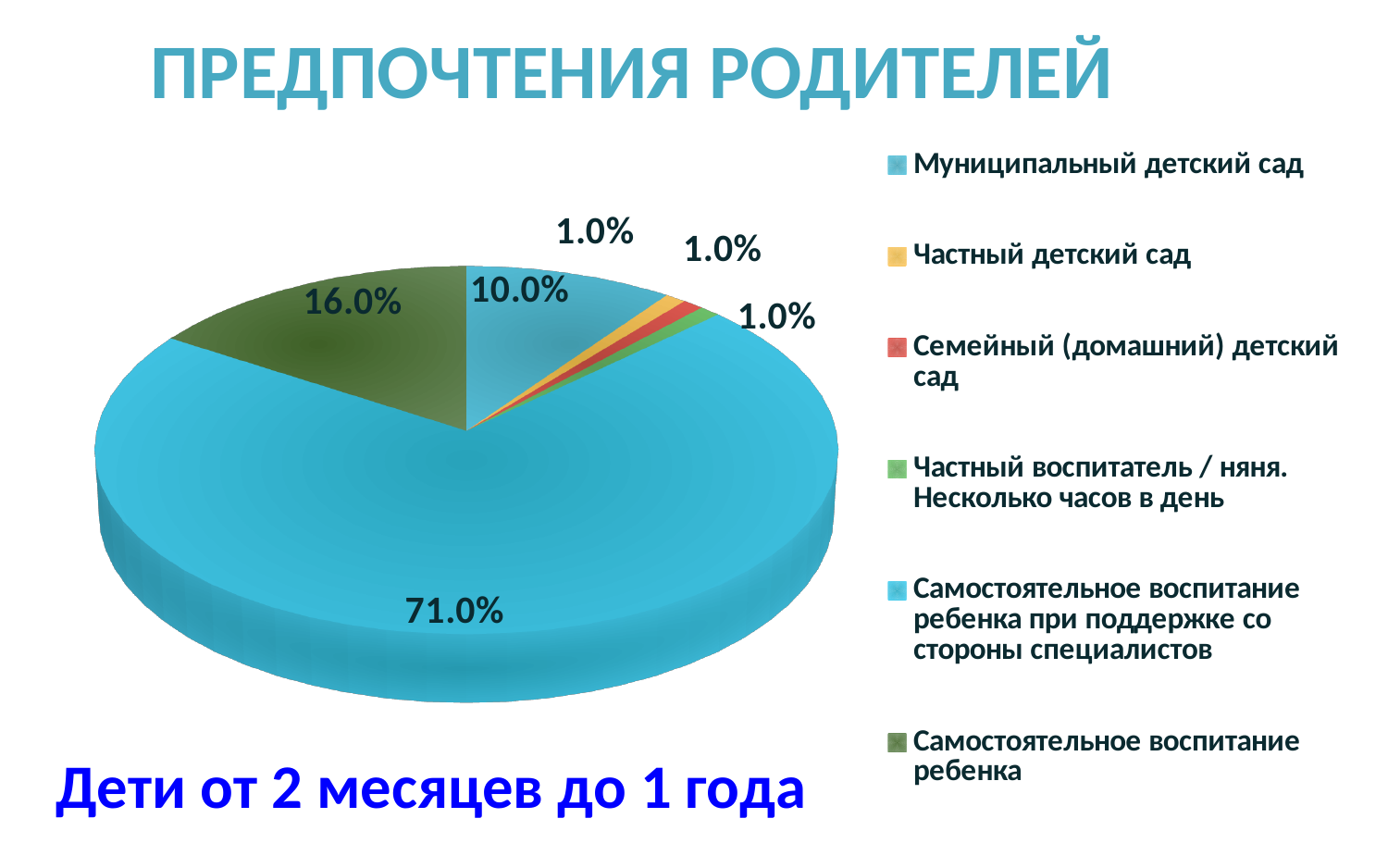
What share of the pie does "Самостоятельное воспитание ребенка при поддержке со стороны специалистов" have? 71.0% What type of chart is shown on the slide? Pie chart How many slices of the pie are labelled 1.0%? 3 What share of the pie does "Муниципальный детский сад" have? 10.0% How many categories does the legend list? 6 Which category has the largest slice of the pie? Самостоятельное воспитание ребенка при поддержке со стороны специалистов Which age group does the caption below the chart refer to? Дети от 2 месяцев до 1 года What share of the pie does "Частный детский сад" have? 1.0% Which is larger: the share for "Муниципальный детский сад" or the share for "Самостоятельное воспитание ребенка"? Самостоятельное воспитание ребенка What is the difference between the shares of "Самостоятельное воспитание ребенка при поддержке со стороны специалистов" and "Самостоятельное воспитание ребенка"? 55.0% What share of the pie does "Самостоятельное воспитание ребенка" have? 16.0% What is the title of the chart? ПРЕДПОЧТЕНИЯ РОДИТЕЛЕЙ